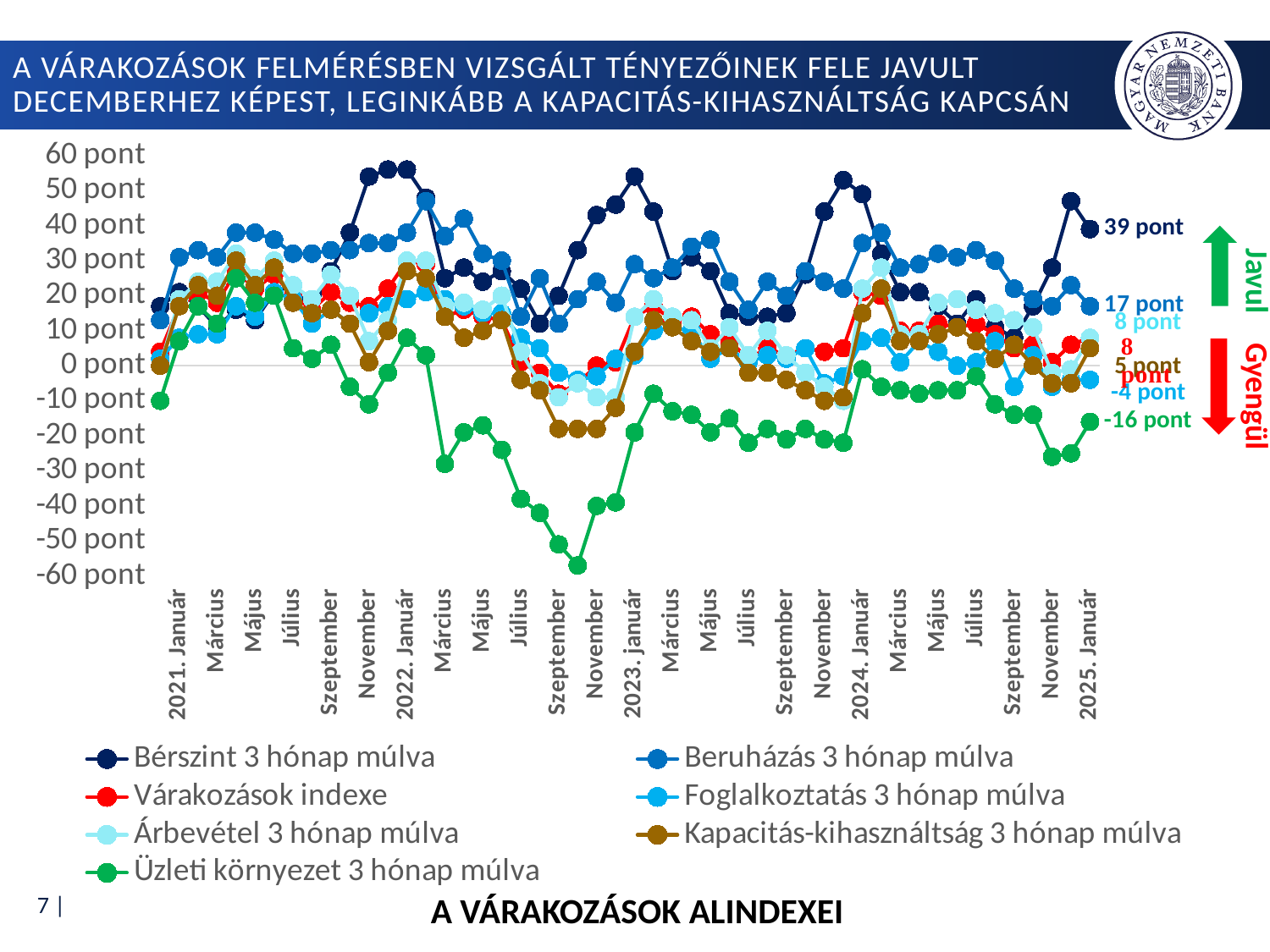
Which series has the lowest value at 2025. Január? Üzleti környezet 3 hónap múlva How many series does the legend of the chart list? 7 What is the value of 'Beruházás 3 hónap múlva' at 2025. Január, as labelled at the end of the line? 17 pont What is the value of 'Foglalkoztatás 3 hónap múlva' at 2025. Január, as labelled at the end of the line? -4 pont At 2025. Január, how much higher is 'Bérszint 3 hónap múlva' than 'Beruházás 3 hónap múlva'? 22 pont What is the value of 'Kapacitás-kihasználtság 3 hónap múlva' at 2025. Január, as labelled at the end of the line? 5 pont What is the value of 'Üzleti környezet 3 hónap múlva' at 2025. Január, as labelled at the end of the line? -16 pont Is the lowest point of the 'Üzleti környezet 3 hónap múlva' line (in late 2022) greater or less than -50 pont? less What kind of chart is shown on the slide? line chart Which series has the highest value at 2025. Január? Bérszint 3 hónap múlva What is the title of the chart? A VÁRAKOZÁSOK ALINDEXEI What is the value of 'Bérszint 3 hónap múlva' at 2025. Január, as labelled at the end of the line? 39 pont